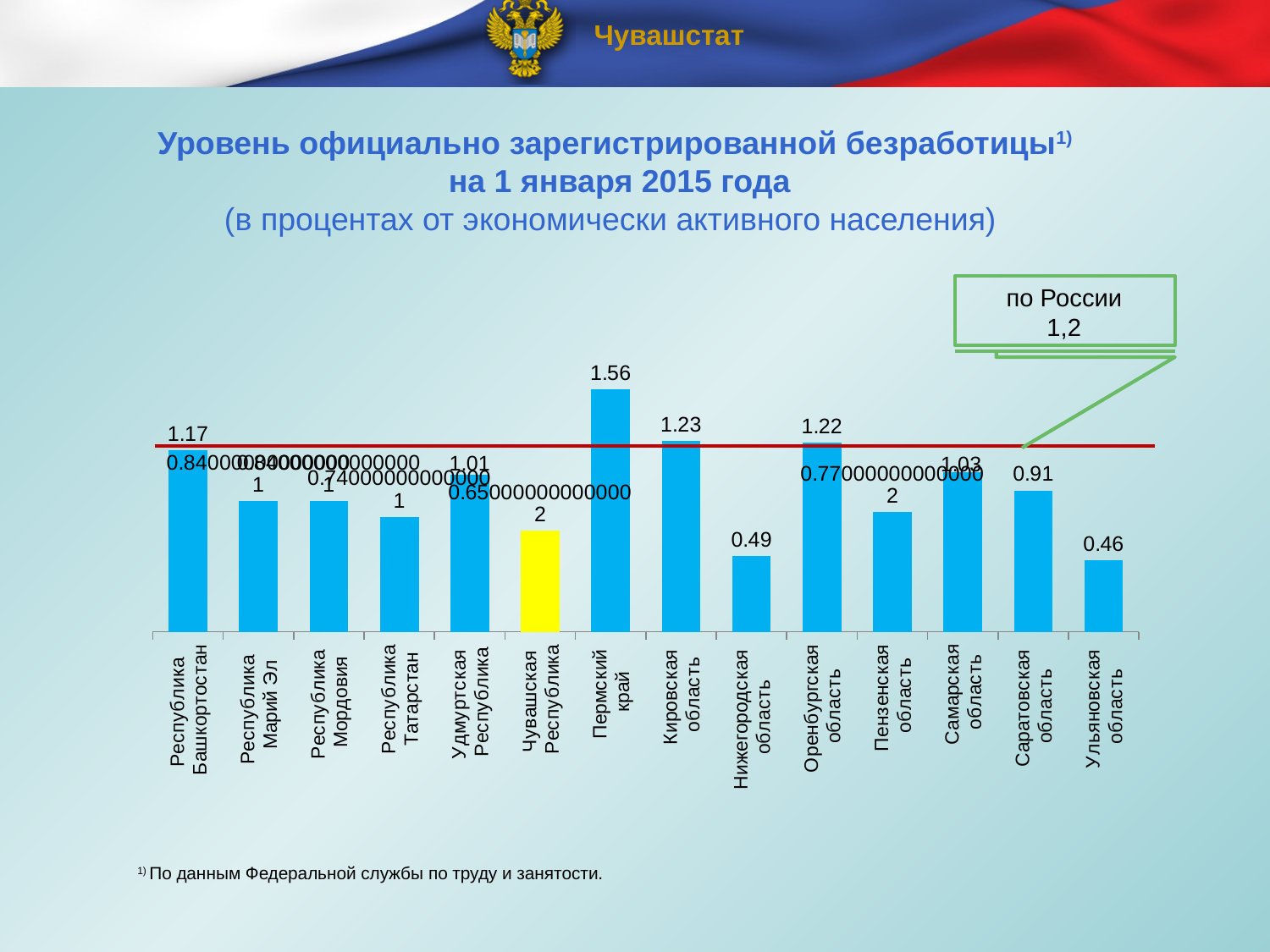
Which region has the lowest registered unemployment rate on the chart? Ульяновская область What value is shown for Республика Башкортостан? 1.17 Which is larger, the value for Республика Башкортостан or for Саратовская область? Республика Башкортостан What value is shown for Кировская область? 1.23 What kind of chart is shown on the slide? Bar chart What is the registered unemployment rate shown for Пермский край? 1.56 How many regions are shown on the chart? 14 What value is shown for Ульяновская область? 0.46 Which region has the highest registered unemployment rate on the chart? Пермский край What value for Russia as a whole (по России) is shown in the callout box? 1,2 What is the difference between the values for Пермский край and Республика Башкортостан? 0.39 What value is shown for Саратовская область? 0.91